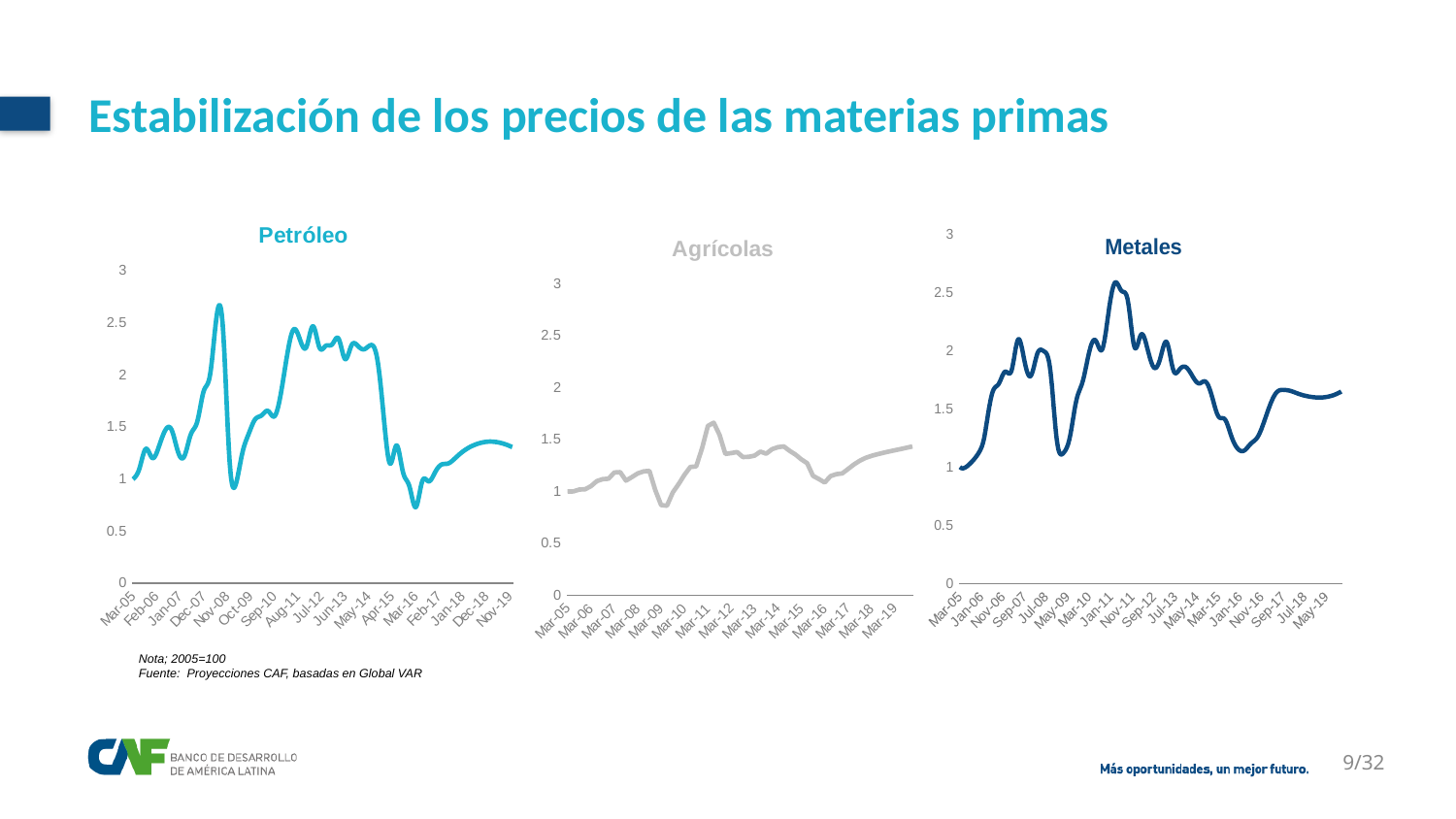
In the Petróleo chart, do values rise or fall between Mar-05 and the peak around 2008? rise In the Petróleo chart, is the lowest value reached around 2016 greater or less than 1? less In the Agrícolas chart, is the highest value reached around 2011 greater or less than 2? less Which of the three charts is drawn with a grey line? Agrícolas In the Petróleo chart, is the peak value reached around 2008 greater or less than 2? greater How many charts are shown on the slide? 3 In the Metales chart, do values rise or fall between Mar-05 and the peak around 2011? rise What is the highest value shown on the vertical axis of the Metales chart? 3 What kind of chart is the Petróleo chart? line chart